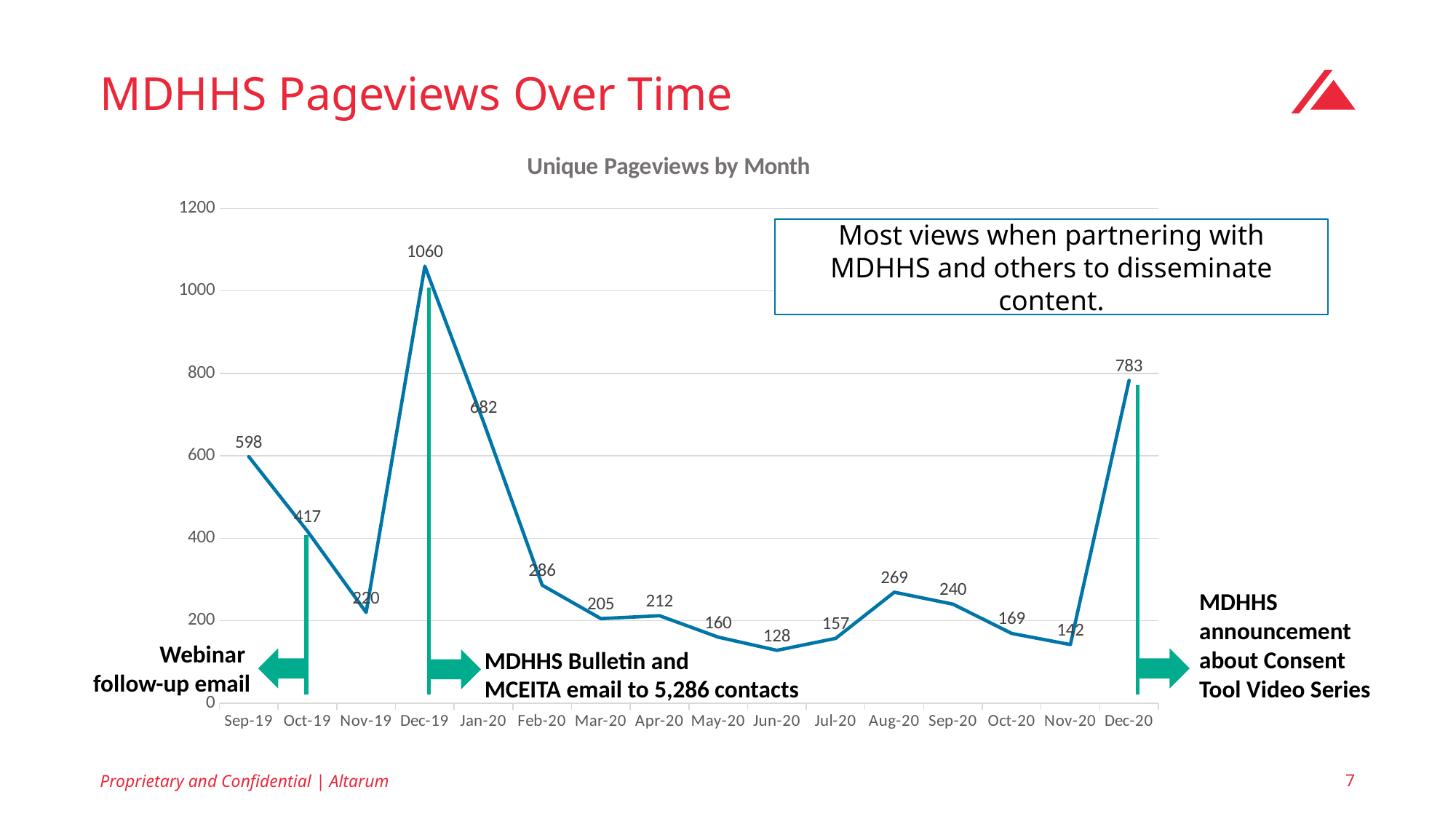
Which is larger, the value for Sep-19 or the value for Dec-20? Dec-20 What is the value for Jun-20? 128 Do the values rise or fall from Feb-20 to Jun-20? fall Which month has the lowest number of unique pageviews? Jun-20 What is the value for Dec-20? 783 What is the value for Dec-19? 1060 What is the title of the chart? Unique Pageviews by Month What kind of chart is shown on the slide? line chart Which month has the highest number of unique pageviews? Dec-19 How many months are plotted on the chart? 16 What is the difference between the values for Dec-19 and Jan-20? 378 Is the value for Feb-20 greater or less than 400? less